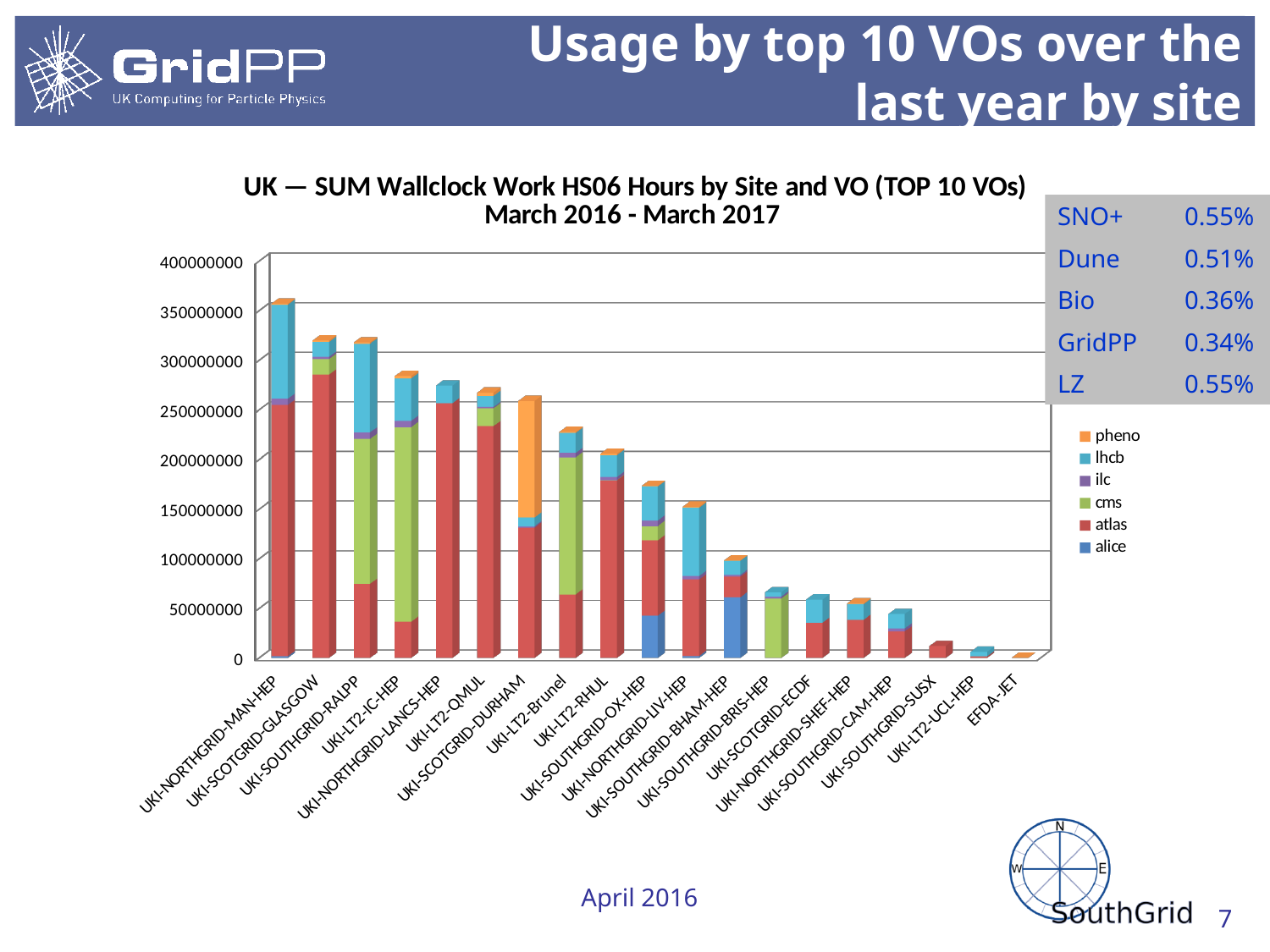
Is the total value for UKI-SOUTHGRID-OX-HEP greater or less than 150000000? greater What kind of chart is shown on the slide? stacked bar chart Is the total value for UKI-SCOTGRID-DURHAM greater or less than 200000000? greater Which site has the lowest total wallclock work in the chart? EFDA-JET Is the total value for UKI-NORTHGRID-MAN-HEP greater or less than 300000000? greater Which VO is shown in orange in the chart legend? pheno Which site has a larger total, UKI-SCOTGRID-GLASGOW or UKI-LT2-RHUL? UKI-SCOTGRID-GLASGOW Which site has the highest total wallclock work in the chart? UKI-NORTHGRID-MAN-HEP How many series does the chart legend list? 6 How many sites are shown along the x axis of the chart? 19 Do the total values rise or fall moving from left to right along the x axis? fall